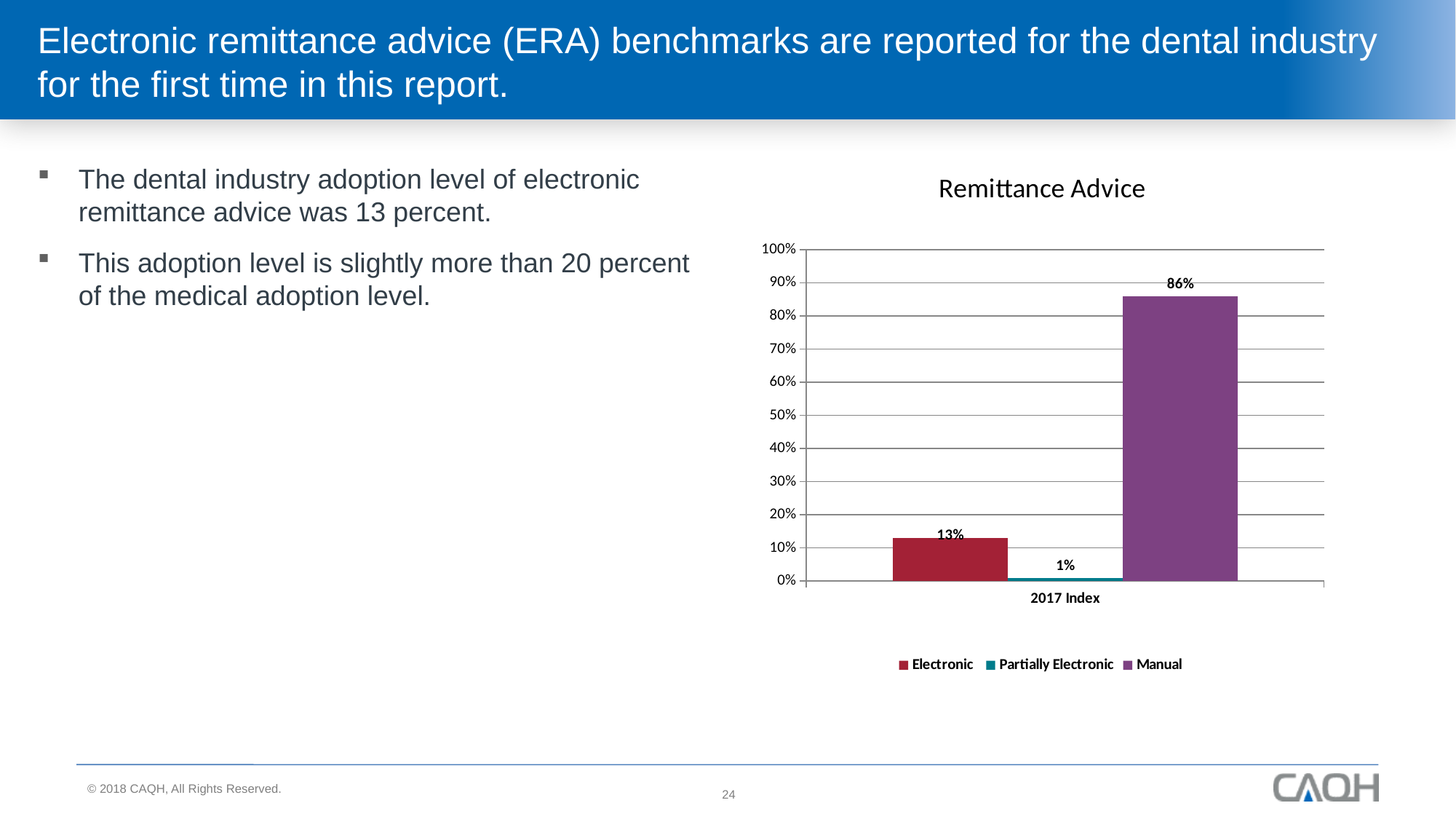
Which series has the lowest value in the Remittance Advice chart? Partially Electronic What is the value for Partially Electronic in the Remittance Advice chart? 1% What is the value for Manual in the Remittance Advice chart? 86% How many series does the legend of the Remittance Advice chart list? 3 Which is larger in the Remittance Advice chart, Electronic or Manual? Manual What is the difference between the Manual and Electronic values in the Remittance Advice chart? 73% Which series has the highest value in the Remittance Advice chart? Manual What kind of chart is the Remittance Advice chart? bar chart Is the value for Manual greater or less than 80%? greater What is the value for Electronic in the Remittance Advice chart? 13% What is the x-axis category label in the Remittance Advice chart? 2017 Index What is the difference between the Electronic and Partially Electronic values in the Remittance Advice chart? 12%